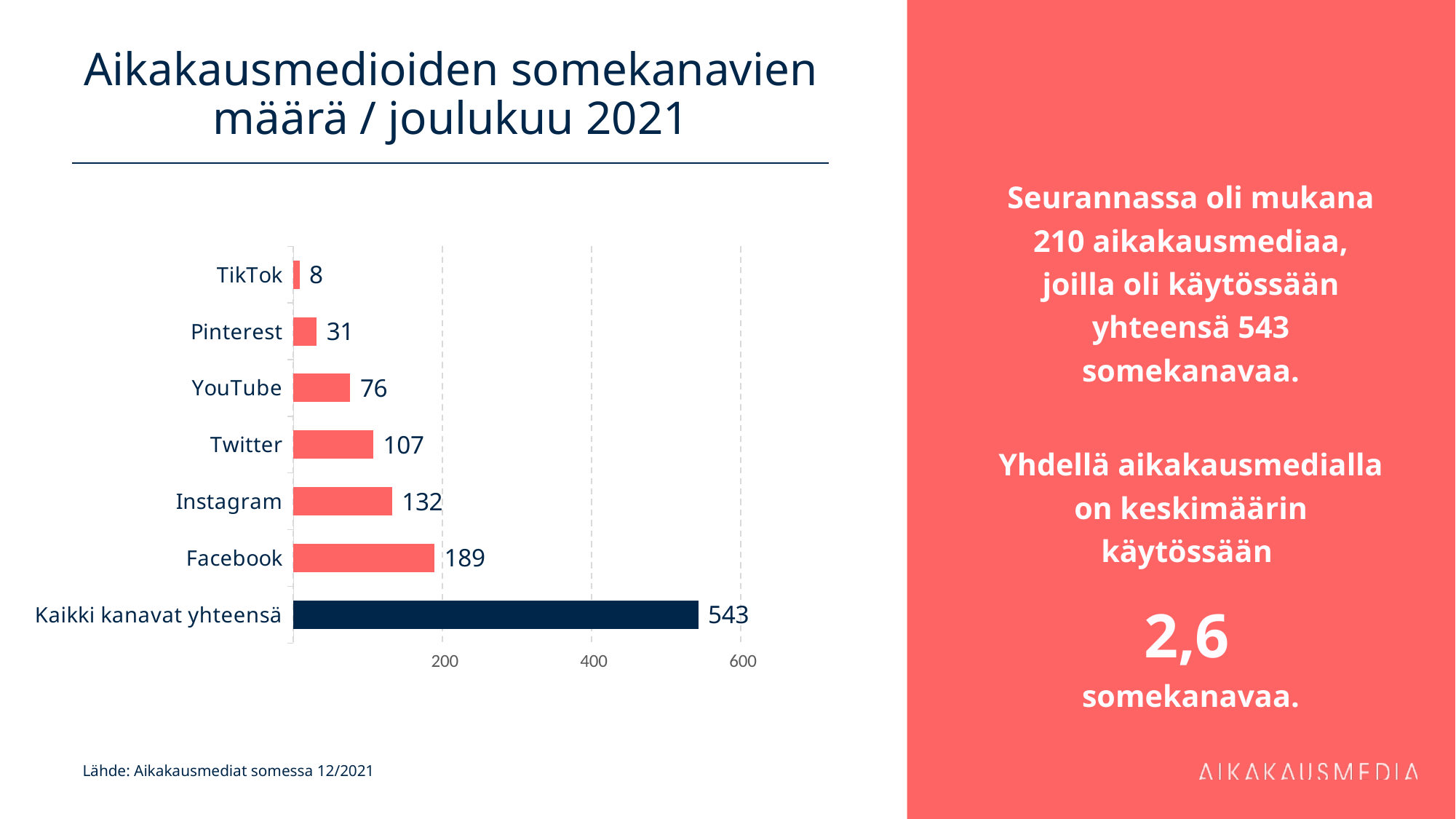
What is the value for Facebook? 189 How many bars are shown in the chart? 7 What is the title of the chart? Aikakausmedioiden somekanavien määrä / joulukuu 2021 Among the individual channels (excluding the total bar), which has the highest value? Facebook Which category has the lowest value? TikTok What is the value for TikTok? 8 Is the value for Facebook greater or less than 200? less Which is larger, the value for Twitter or the value for YouTube? Twitter What kind of chart is shown on the slide? bar chart What is the value for Kaikki kanavat yhteensä? 543 What is the value for Instagram? 132 What is the difference between the values for Facebook and Instagram? 57